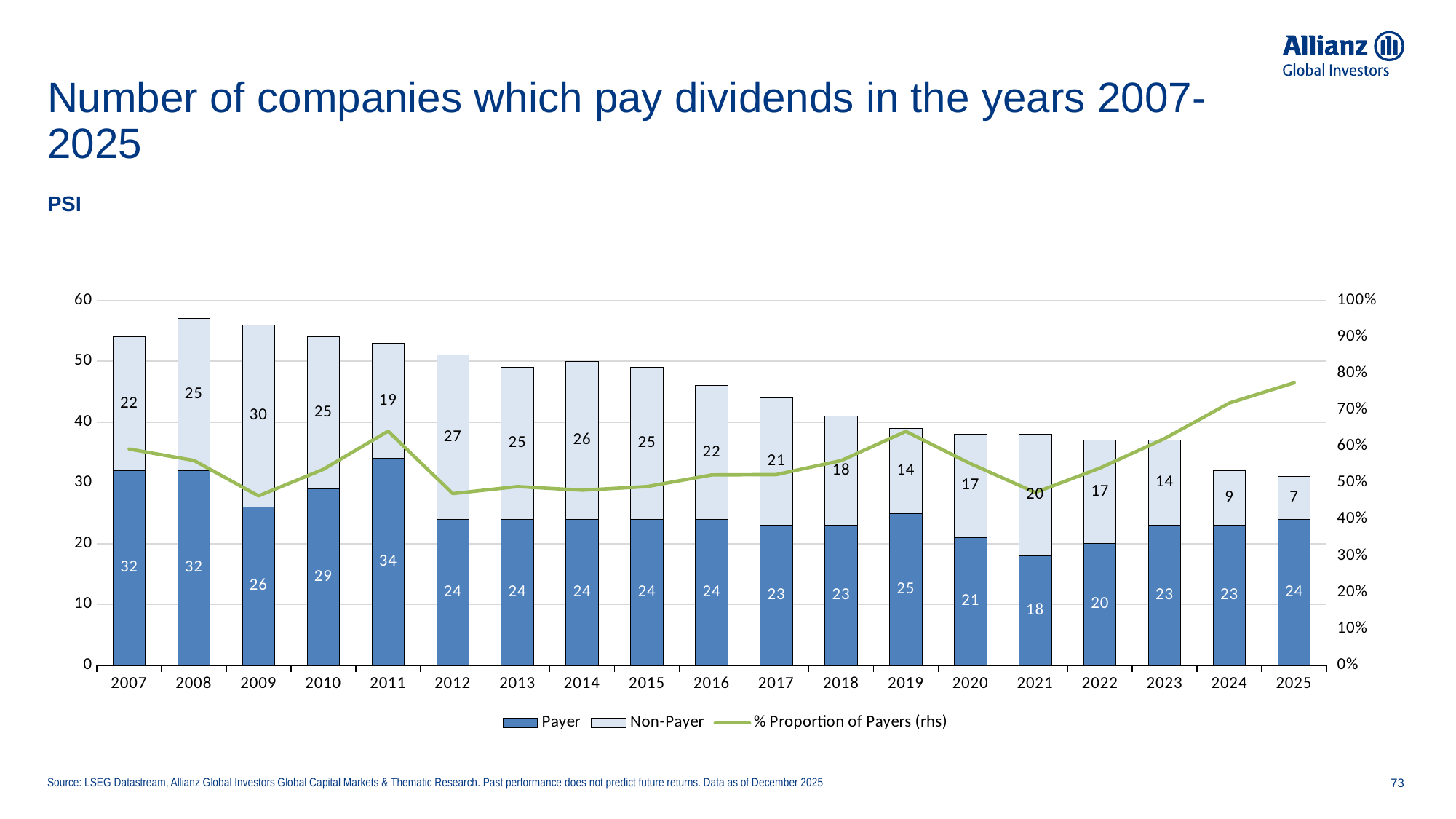
What is the Non-Payer value for 2009? 30 Which is larger in 2012, the Payer value or the Non-Payer value? Non-Payer What is the difference between the Payer and Non-Payer values in 2025? 17 Which year has the lowest Non-Payer value? 2025 How many series does the legend list? 3 How many Payer companies are shown for 2011? 34 What is the total height of the stacked bar for 2008 (Payer plus Non-Payer)? 57 Is the % Proportion of Payers for 2025 greater or less than 70%? greater Which year has the highest Payer value? 2011 Is the % Proportion of Payers for 2009 greater or less than 50%? less Which year has the lowest Payer value? 2021 How many years are shown on the x axis? 19